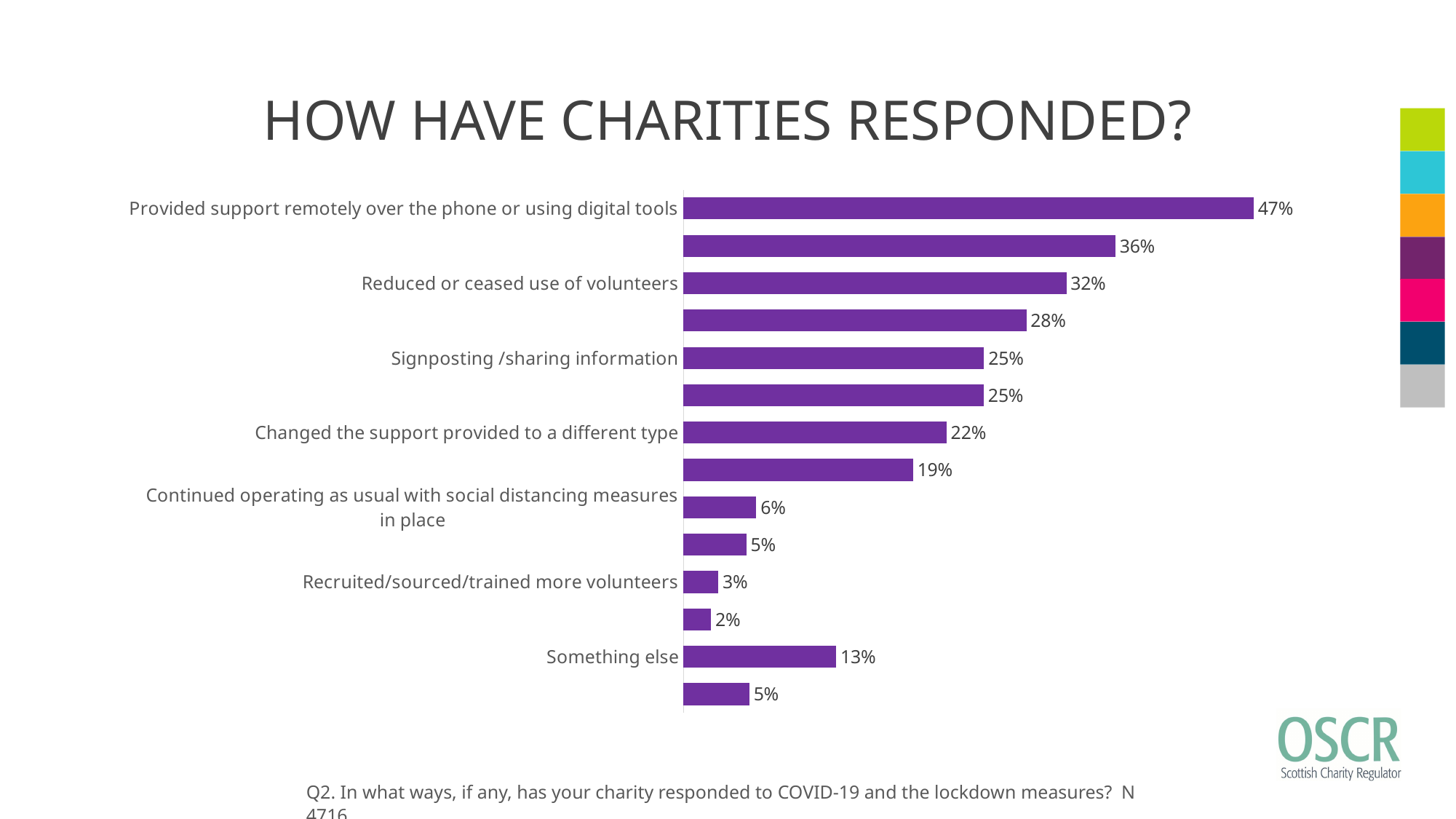
What is the difference between 'Provided support remotely over the phone or using digital tools' and 'Reduced or ceased use of volunteers'? 15 percentage points What is the value for 'Recruited/sourced/trained more volunteers'? 3% What percentage of charities continued operating as usual with social distancing measures in place? 6% What is the value for 'Reduced or ceased use of volunteers'? 32% How many bars are plotted in the chart? 14 What percentage is shown for 'Something else'? 13% Which is larger: 'Something else' or 'Continued operating as usual with social distancing measures in place'? Something else What type of chart is shown on the slide? Bar chart What percentage is shown for 'Signposting /sharing information'? 25% Which response has the highest percentage in the chart? Provided support remotely over the phone or using digital tools What is the value for 'Changed the support provided to a different type'? 22% What percentage of charities provided support remotely over the phone or using digital tools? 47%